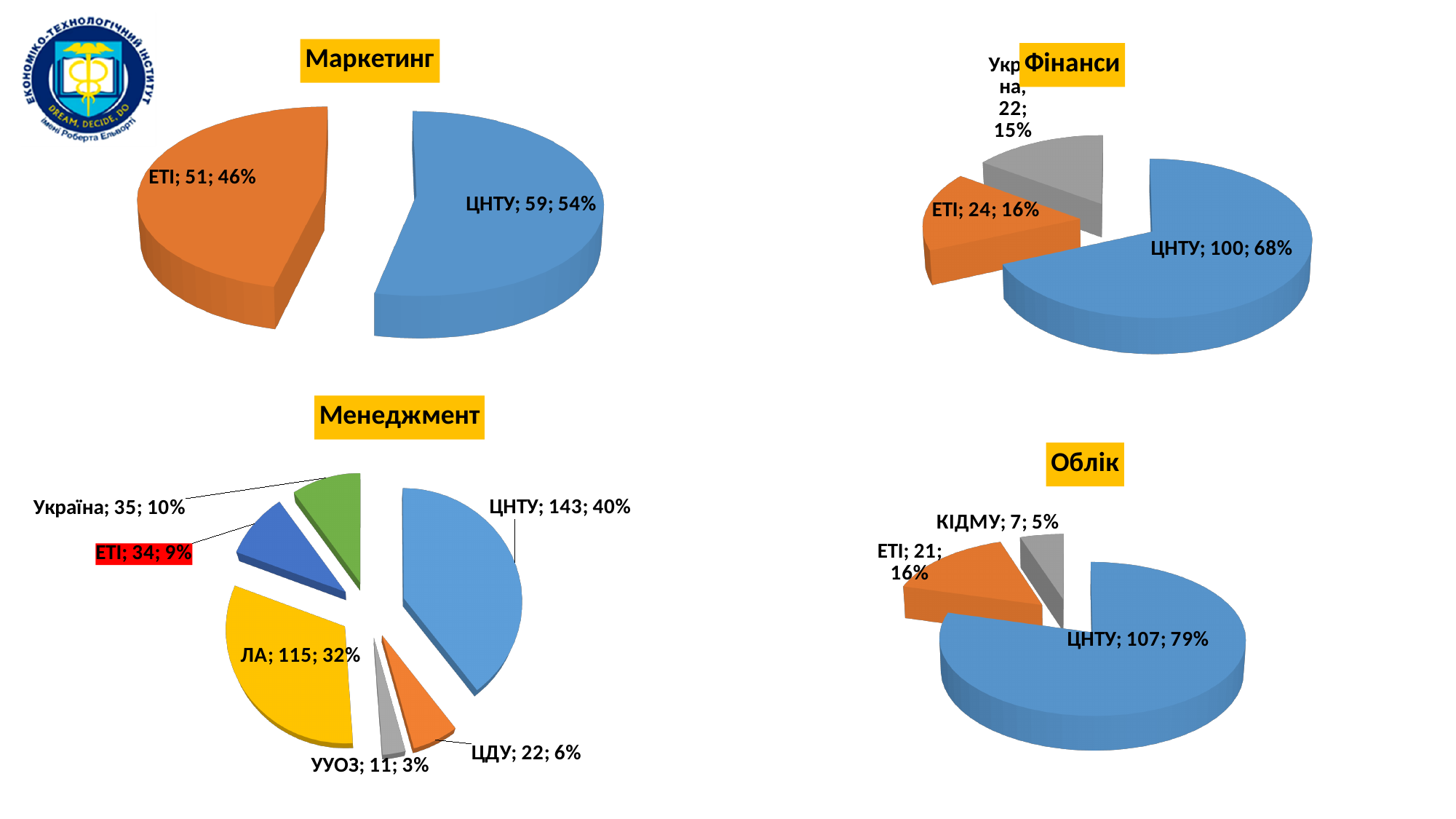
In the Менеджмент chart, what value is shown for ЛА? 115 In the Облік chart, what value is shown for КІДМУ? 7 In the Фінанси chart, which category has the smallest slice? Україна In the Облік chart, what share of the pie does ЦНТУ have? 79% What type of chart is the Облік chart? Pie chart In the Маркетинг chart, what share of the pie does ЕТІ have? 46% In the Фінанси chart, what value is shown for ЦНТУ? 100 In the Менеджмент chart, which is larger, the value for Україна or the value for ЦДУ? Україна How many categories are shown in the Менеджмент chart? 6 In the Маркетинг chart, what value is shown for ЦНТУ? 59 In the Менеджмент chart, which category has the largest slice? ЦНТУ In the Фінанси chart, what is the difference between the values for ЦНТУ and ЕТІ? 76